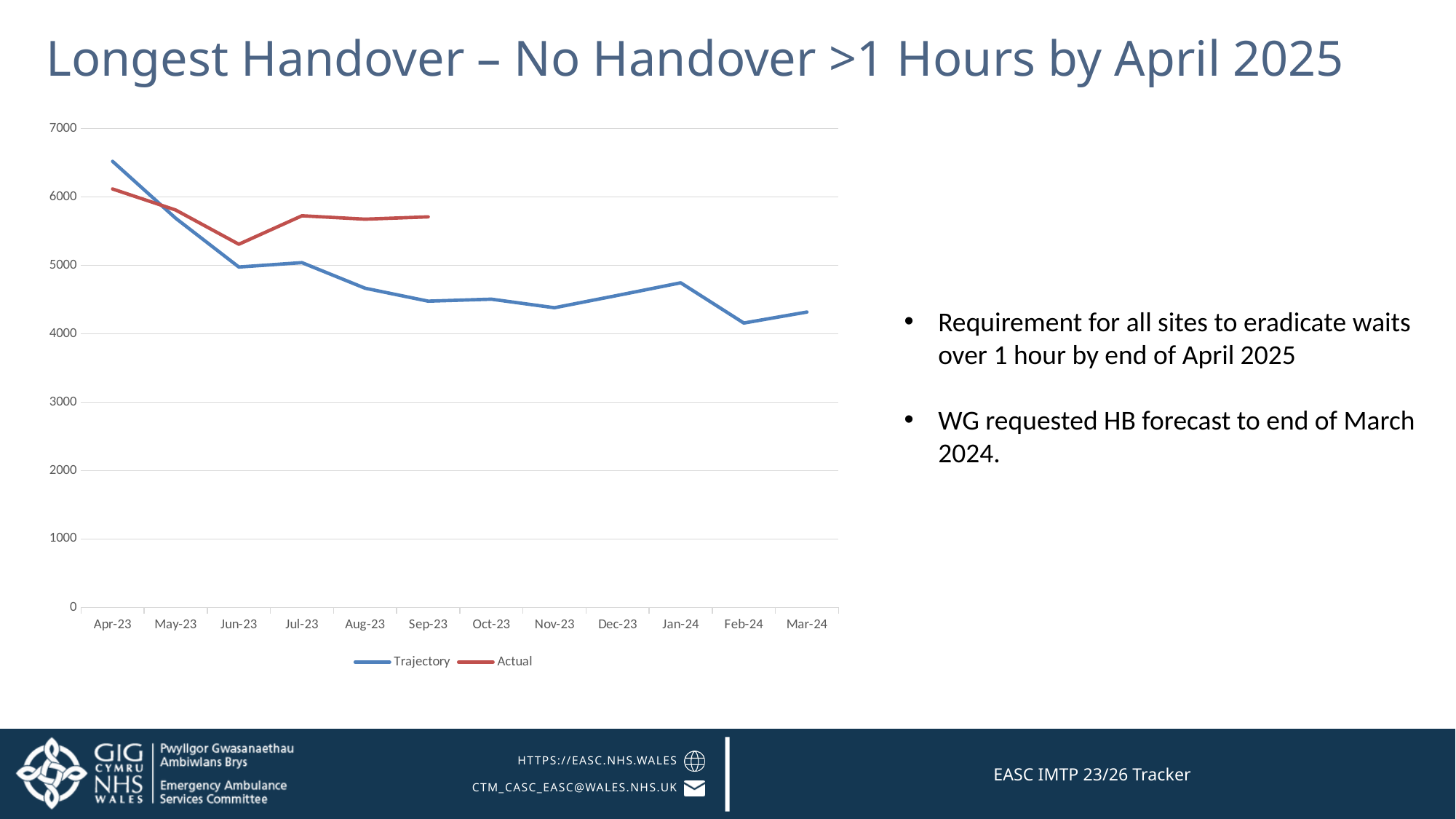
What kind of chart is shown on the slide? Line chart Is the Trajectory value for Apr-23 greater or less than 6000? greater How many series does the chart legend list? 2 Is the Trajectory value for Nov-23 greater or less than 5000? less In Sep-23, which series has the larger value, Trajectory or Actual? Actual In which month is the Trajectory series at its highest value? Apr-23 In which month is the Trajectory series at its lowest value? Feb-24 Is the Actual value for Jun-23 greater or less than 5000? greater What are the two series named in the chart legend? Trajectory and Actual In which month is the Actual series at its lowest value? Jun-23 Does the Trajectory series generally rise or fall from Apr-23 to Mar-24? Fall How many months are shown along the x axis of the chart? 12